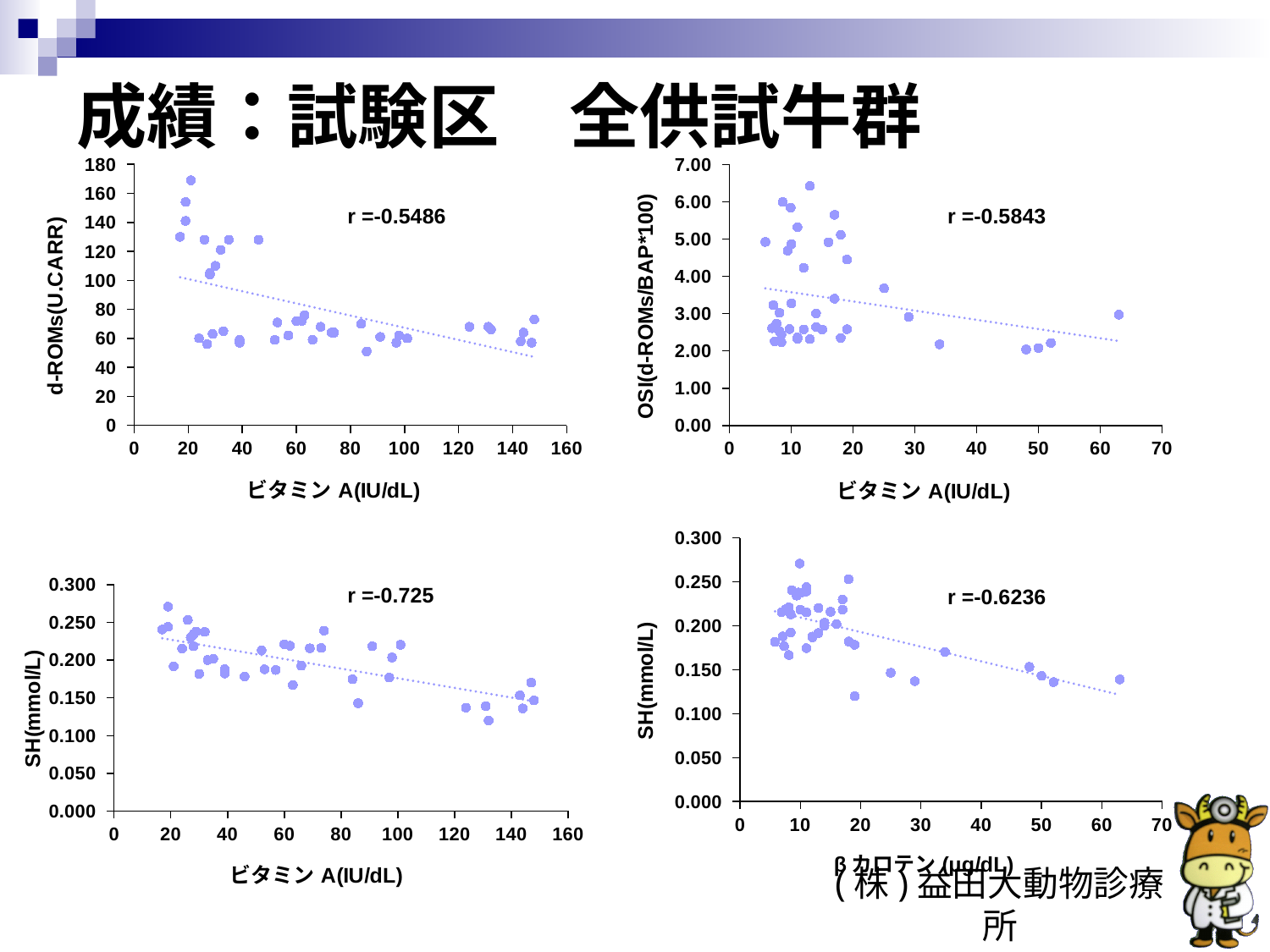
What kind of chart is the top-left chart (d-ROMs vs ビタミン A)? scatter plot What correlation coefficient is printed on the top-left chart (d-ROMs vs ビタミン A)? r =-0.5486 In the top-right chart (OSI vs ビタミン A), is the highest OSI value greater or less than 6.00? greater In the bottom-right chart (SH vs βカロテン), is the largest βカロテン value plotted greater or less than 60? greater In the top-left chart (d-ROMs vs ビタミン A), is the highest d-ROMs value greater or less than 160? greater Based on the printed r values, which of the four charts shows the strongest negative correlation? bottom-left chart (SH vs ビタミン A, r =-0.725) In the top-right chart (OSI vs ビタミン A), does the trend line rise or fall as ビタミン A increases? fall In the bottom-right chart (SH vs βカロテン), does the trend line rise or fall as βカロテン increases? fall How many charts are shown on the slide? 4 What correlation coefficient is printed on the bottom-left chart (SH vs ビタミン A)? r =-0.725